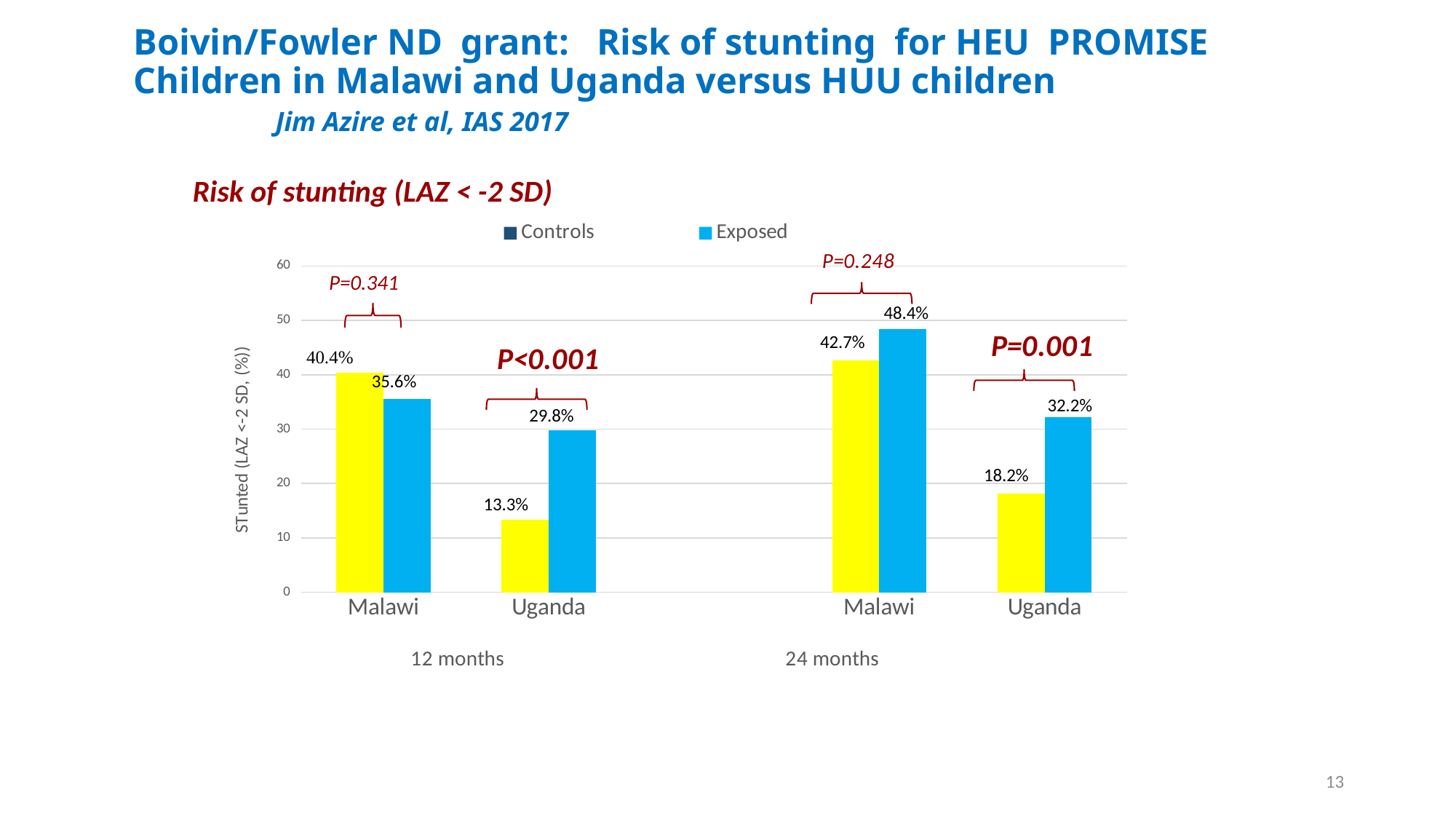
What is the stunting value for Exposed children in Uganda at 12 months? 29.8% What is the stunting value for Exposed children in Malawi at 24 months? 48.4% What kind of chart is shown on the slide? Bar chart What is the stunting value for Controls in Uganda at 12 months? 13.3% At 12 months in Malawi, which group has the higher stunting value, Controls or Exposed? Controls How many series does the legend list? 2 What is the difference between the Exposed and Controls values for Uganda at 24 months? 14.0 percentage points Which bar has the highest stunting value on the chart? Exposed, Malawi, 24 months (48.4%) Which bar has the lowest stunting value on the chart? Controls, Uganda, 12 months (13.3%) What p-value is shown for the Uganda comparison at 12 months? P<0.001 What is the stunting value for Controls in Malawi at 24 months? 42.7% What is the difference between the Exposed and Controls values for Uganda at 12 months? 16.5 percentage points